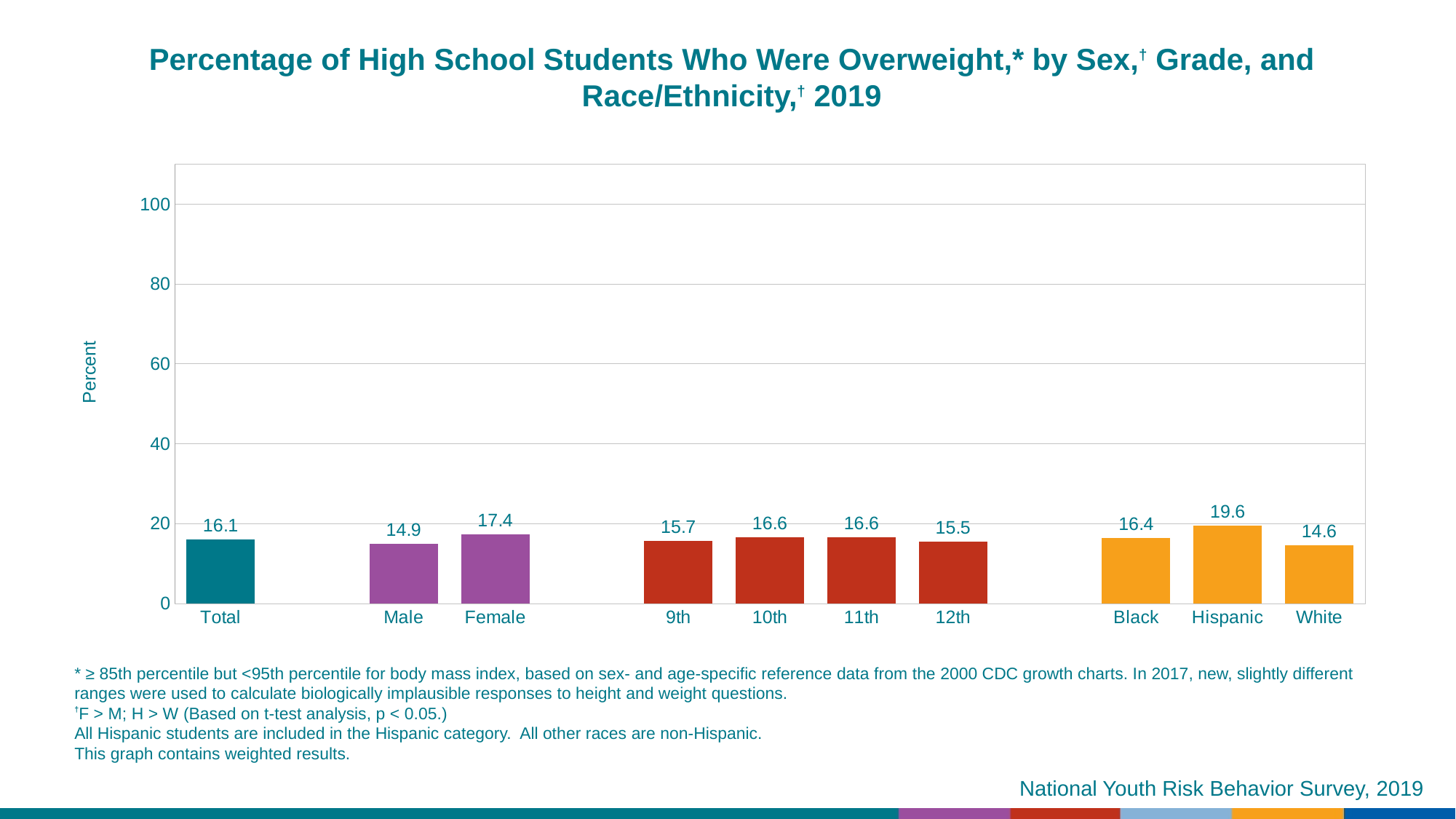
What is the label of the y axis? Percent What is the value for Female? 17.4 How many categories are shown on the x axis? 10 Is the value for Hispanic greater or less than 20? less What is the value for Hispanic? 19.6 What is the difference between the Hispanic and White values? 5.0 Which is larger, the value for 9th or the value for 12th? 9th Which category has the lowest value? White What kind of chart is this? bar chart Which category has the highest value? Hispanic What is the value for Total? 16.1 What is the difference between the Female and Male values? 2.5